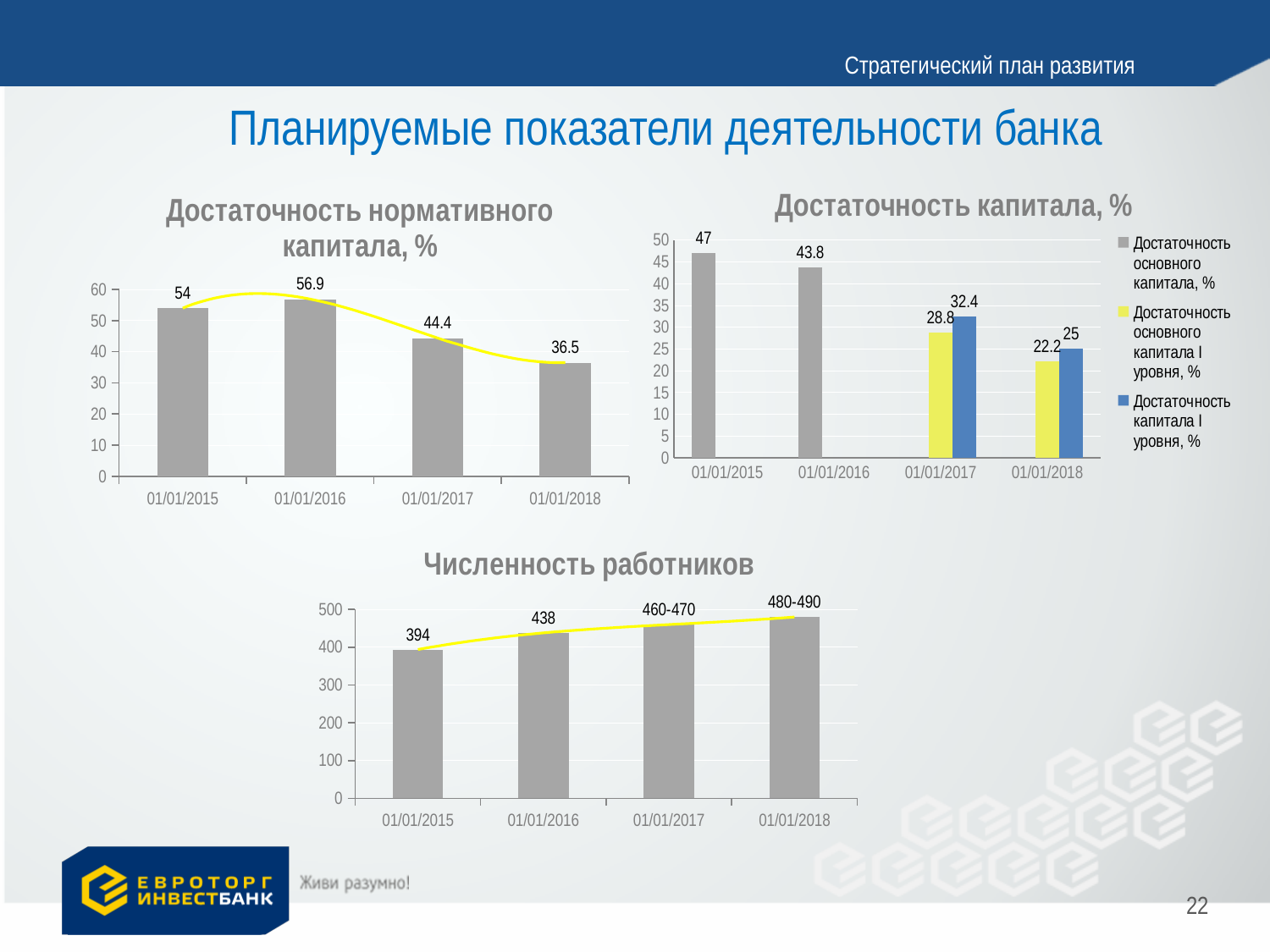
In the chart 'Достаточность нормативного капитала, %', which date has the lowest value? 01/01/2018 In the chart 'Достаточность нормативного капитала, %', what is the value for 01/01/2016? 56.9 In the chart 'Достаточность капитала, %', how many series does the legend list? 3 In the chart 'Численность работников', what is the label shown for 01/01/2018? 480-490 In the chart 'Достаточность капитала, %', what is the value of 'Достаточность основного капитала, %' for 01/01/2015? 47 In the chart 'Численность работников', do the values rise or fall from 01/01/2015 to 01/01/2018? rise In the chart 'Достаточность нормативного капитала, %', how many dates are shown on the x axis? 4 In the chart 'Достаточность капитала, %', what is the value of 'Достаточность капитала I уровня, %' for 01/01/2017? 32.4 What kind of chart is 'Численность работников'? bar chart In the chart 'Достаточность нормативного капитала, %', what is the difference between the values for 01/01/2016 and 01/01/2018? 20.4 In the chart 'Достаточность капитала, %', which is larger for 01/01/2018: 'Достаточность основного капитала I уровня, %' or 'Достаточность капитала I уровня, %'? Достаточность капитала I уровня, % In the chart 'Численность работников', what is the value for 01/01/2015? 394